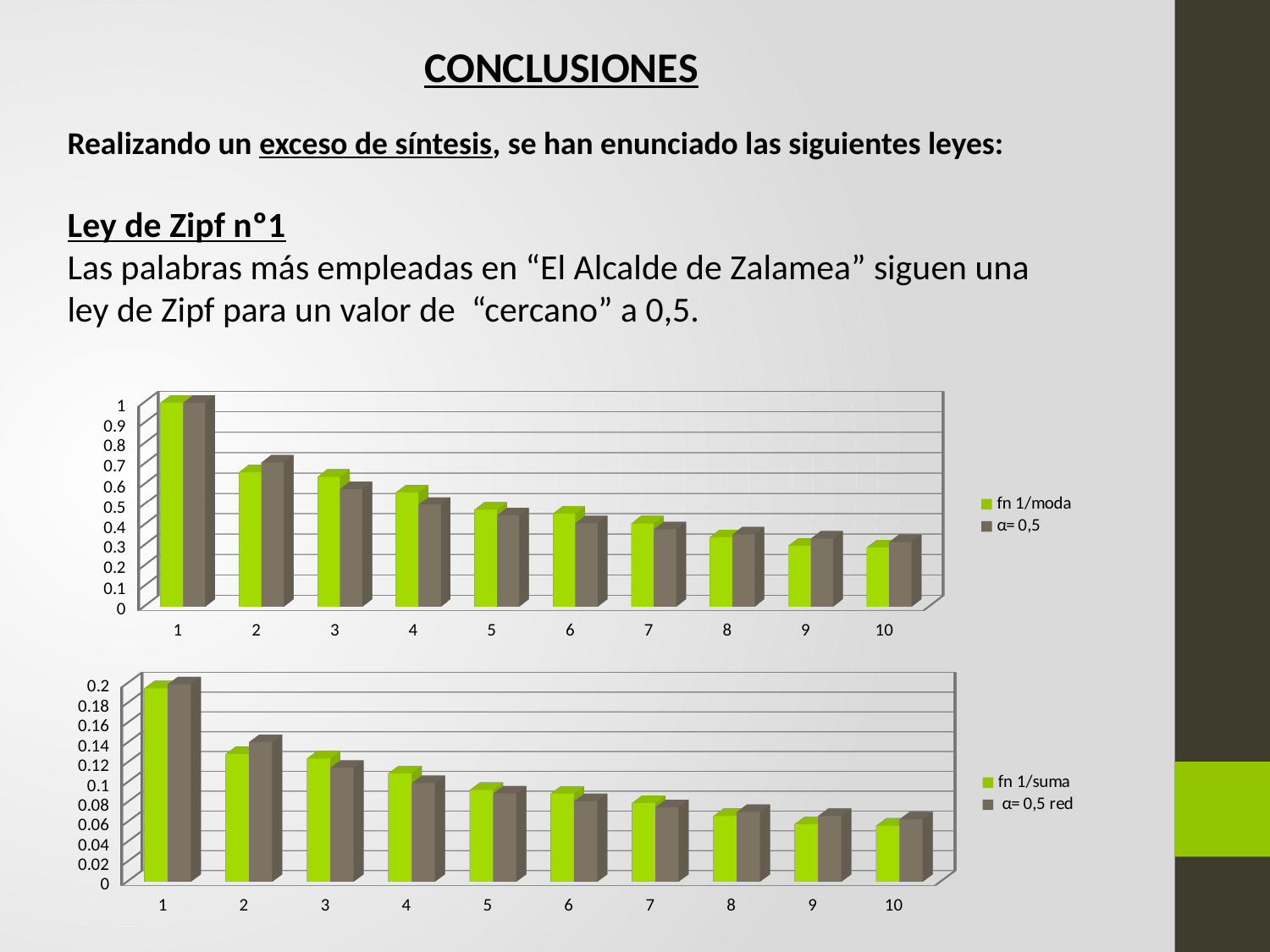
How many categories are shown on the x axis of the top chart? 10 In the top chart, for category 2, which is larger: fn 1/moda or α= 0,5? α= 0,5 In the top chart, which category has the highest fn 1/moda value? 1 How many series does the legend of the bottom chart list? 2 What are the two legend entries of the top chart? fn 1/moda and α= 0,5 How many series does the legend of the top chart list? 2 In the top chart, is the fn 1/moda value for category 2 greater or less than 0.5? greater In the top chart, is the fn 1/moda value for category 10 greater or less than 0.5? less What kind of chart is the top chart on the slide? bar chart In the top chart, do the fn 1/moda values rise or fall from category 1 to category 10? fall In the bottom chart, is the fn 1/suma value for category 1 greater or less than 0.1? greater